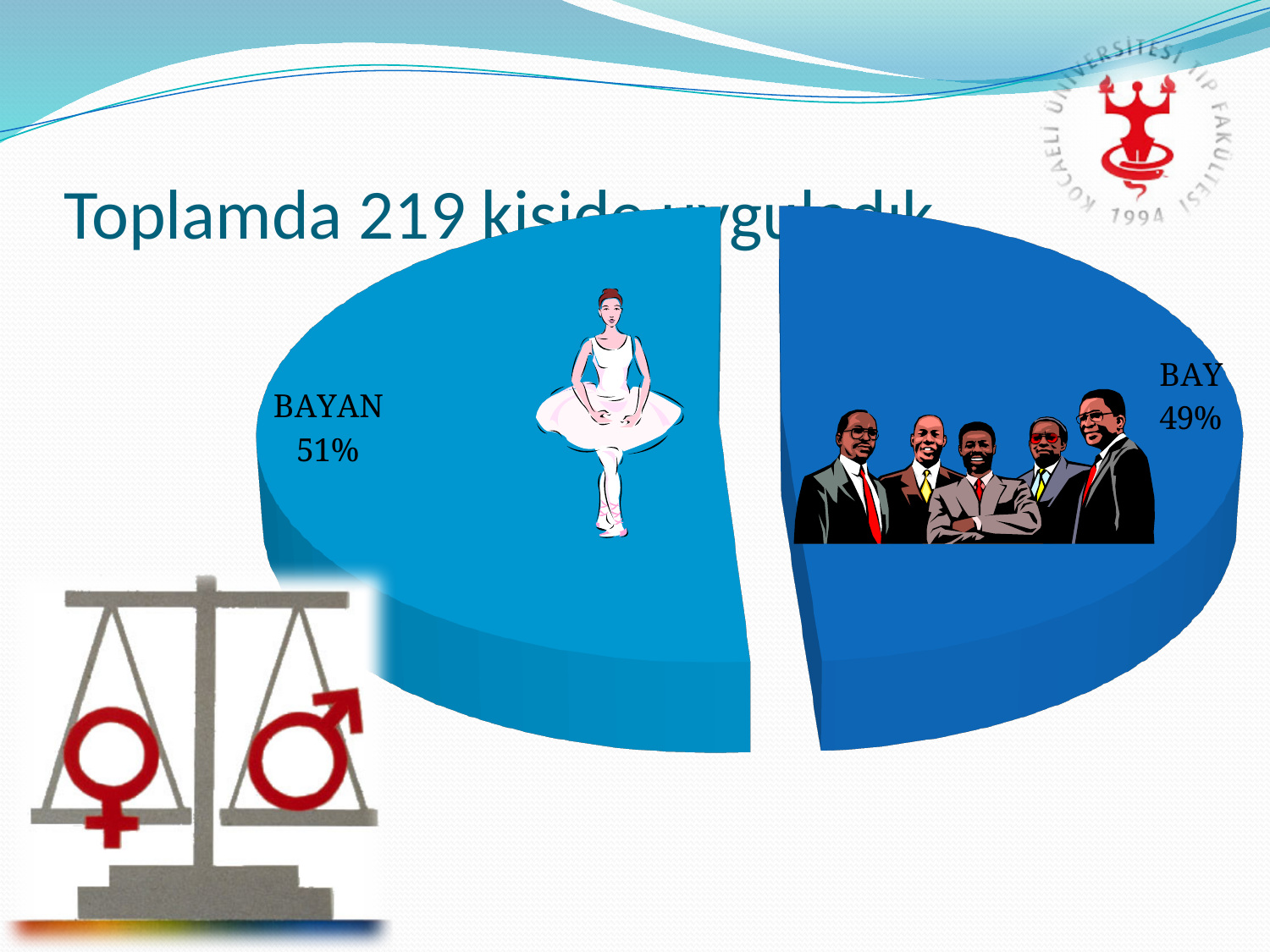
What share of the pie does the BAY slice represent? 49% Is the value for BAY greater or less than 50%? less Is the value for BAYAN greater or less than 50%? greater Which slice of the pie is the smallest? BAY What are the labels of the two slices in the pie chart? BAYAN and BAY What share of the pie does the BAYAN slice represent? 51% What kind of chart is shown on the slide? pie chart What is the difference in percentage points between the BAYAN and BAY slices? 2% Which is larger, the BAYAN slice or the BAY slice? BAYAN According to the slide title, how many people in total were included? 219 Which slice of the pie is the largest? BAYAN How many slices does the pie chart have? 2